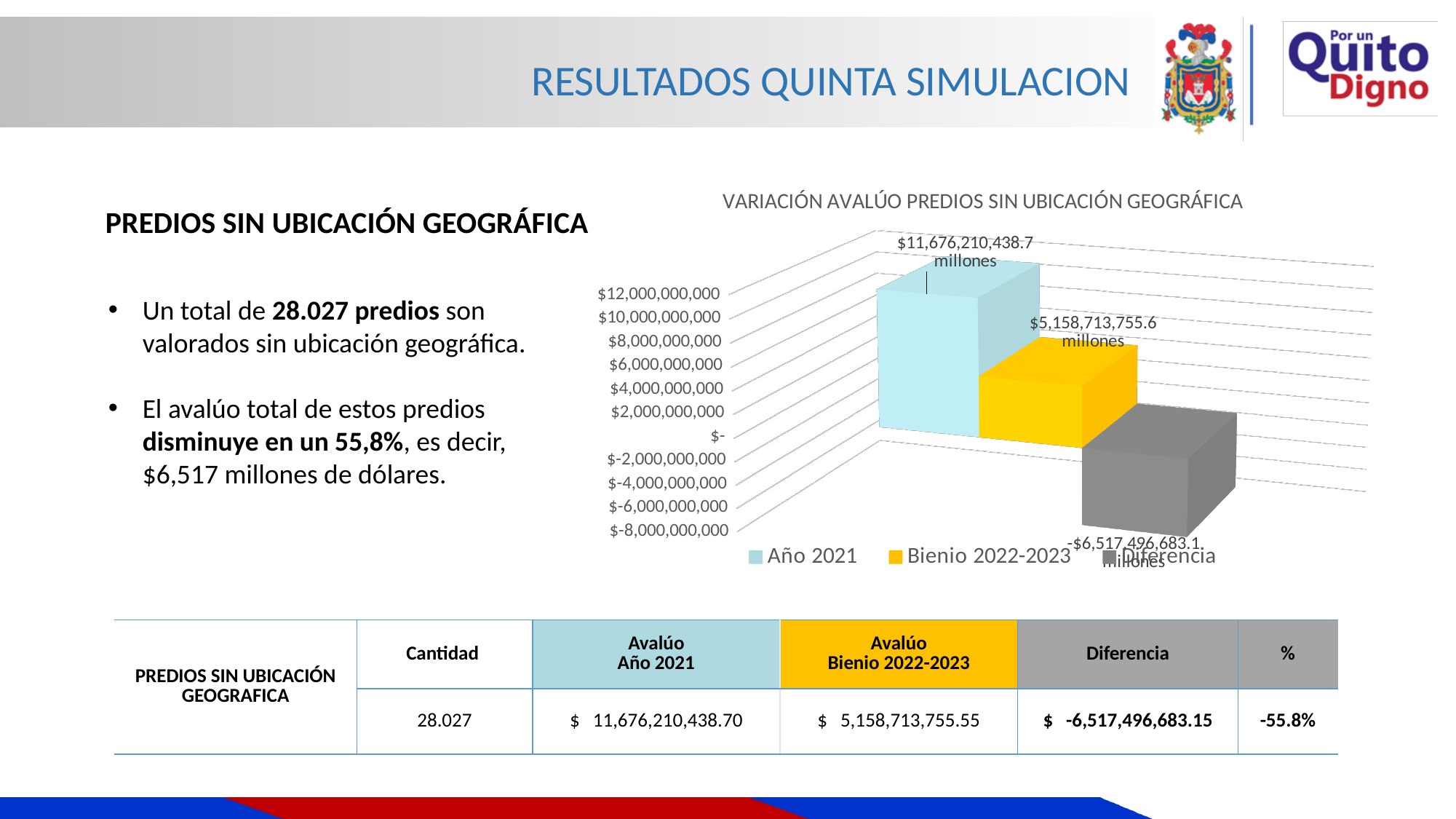
How many series does the chart legend list? 3 Is the value for Bienio 2022-2023 greater or less than $6,000,000,000? less What is the value shown for Año 2021 in the chart? $11,676,210,438.7 millones Is the value for Diferencia greater or less than $-4,000,000,000? less Which series has the lowest value in the chart? Diferencia What is the title of the chart? VARIACIÓN AVALÚO PREDIOS SIN UBICACIÓN GEOGRÁFICA What kind of chart is shown on the slide? Bar chart Which series has the highest value in the chart? Año 2021 What colour is the bar for Bienio 2022-2023 in the chart? Yellow Is the value for Año 2021 greater or less than $10,000,000,000? greater What is the value shown for Bienio 2022-2023 in the chart? $5,158,713,755.6 millones Which is larger in the chart, Año 2021 or Bienio 2022-2023? Año 2021